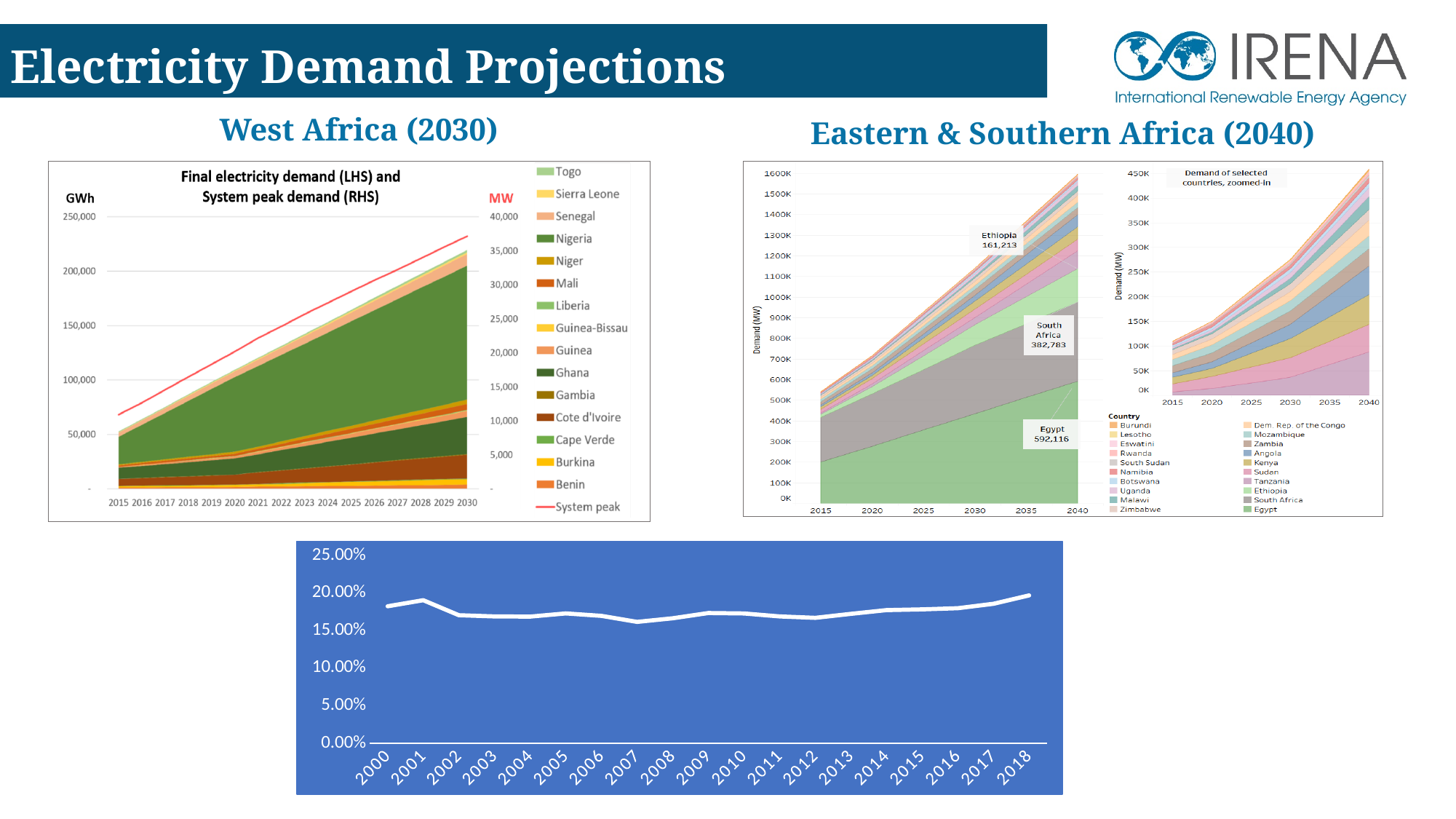
In the Eastern & Southern Africa (2040) chart, which is larger, the labelled value for Egypt or for South Africa? Egypt In the Eastern & Southern Africa (2040) chart, what demand value is labelled for South Africa? 382,783 In the Eastern & Southern Africa (2040) chart, what demand value is labelled for Ethiopia? 161,213 In the Eastern & Southern Africa (2040) chart, what is the difference between the labelled values for Egypt and South Africa? 209,333 In the Eastern & Southern Africa (2040) chart, how many countries does the legend list? 20 In the West Africa (2030) chart, which country accounts for the largest share of final electricity demand? Nigeria In the Eastern & Southern Africa (2040) chart, what demand value is labelled for Egypt? 592,116 In the West Africa (2030) chart, is the System peak value in 2030 greater or less than 35,000 MW? greater What kind of chart is the West Africa (2030) chart on the left? Area chart In the West Africa (2030) chart, how many entries does the legend list? 16 In the West Africa (2030) chart, does final electricity demand rise or fall from 2015 to 2030? Rise In the West Africa (2030) chart, what unit is shown on the left-hand axis? GWh